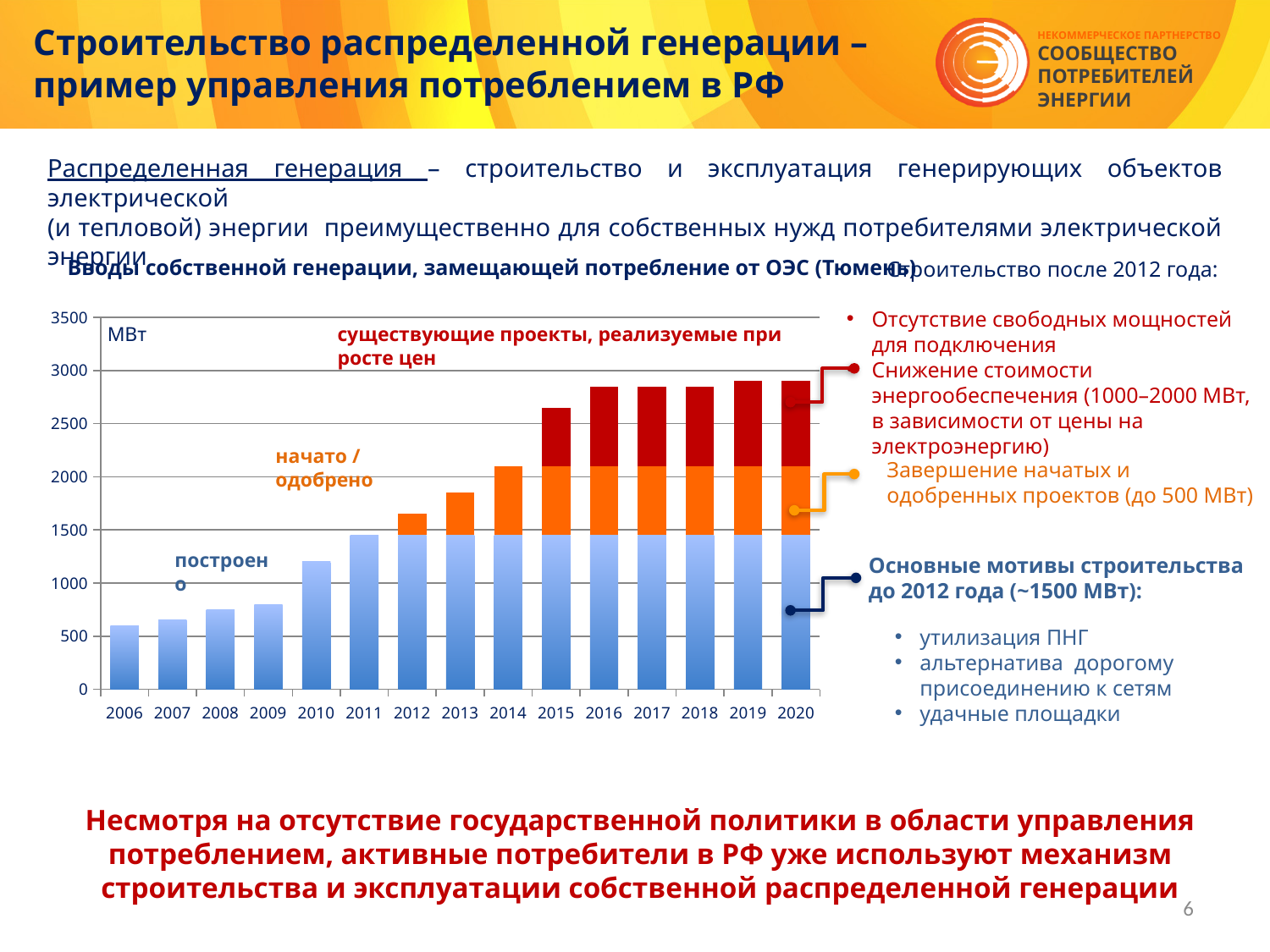
Which year has the lowest total bar in the chart? 2006 What kind of chart is shown on the slide? bar chart Do the total bar values generally rise or fall from 2006 to 2020? rise Is the total bar value for 2012 greater or less than 1500? greater Is the total bar value for 2015 greater or less than 2500? greater What is the first year shown on the x axis of the chart? 2006 Which year has the larger total bar, 2006 or 2010? 2010 Is the total bar value for 2006 greater or less than 1000? less How many years are shown on the x axis of the chart? 15 What is the last year shown on the x axis of the chart? 2020 What unit is shown in the top-left corner of the chart's plot area? МВт